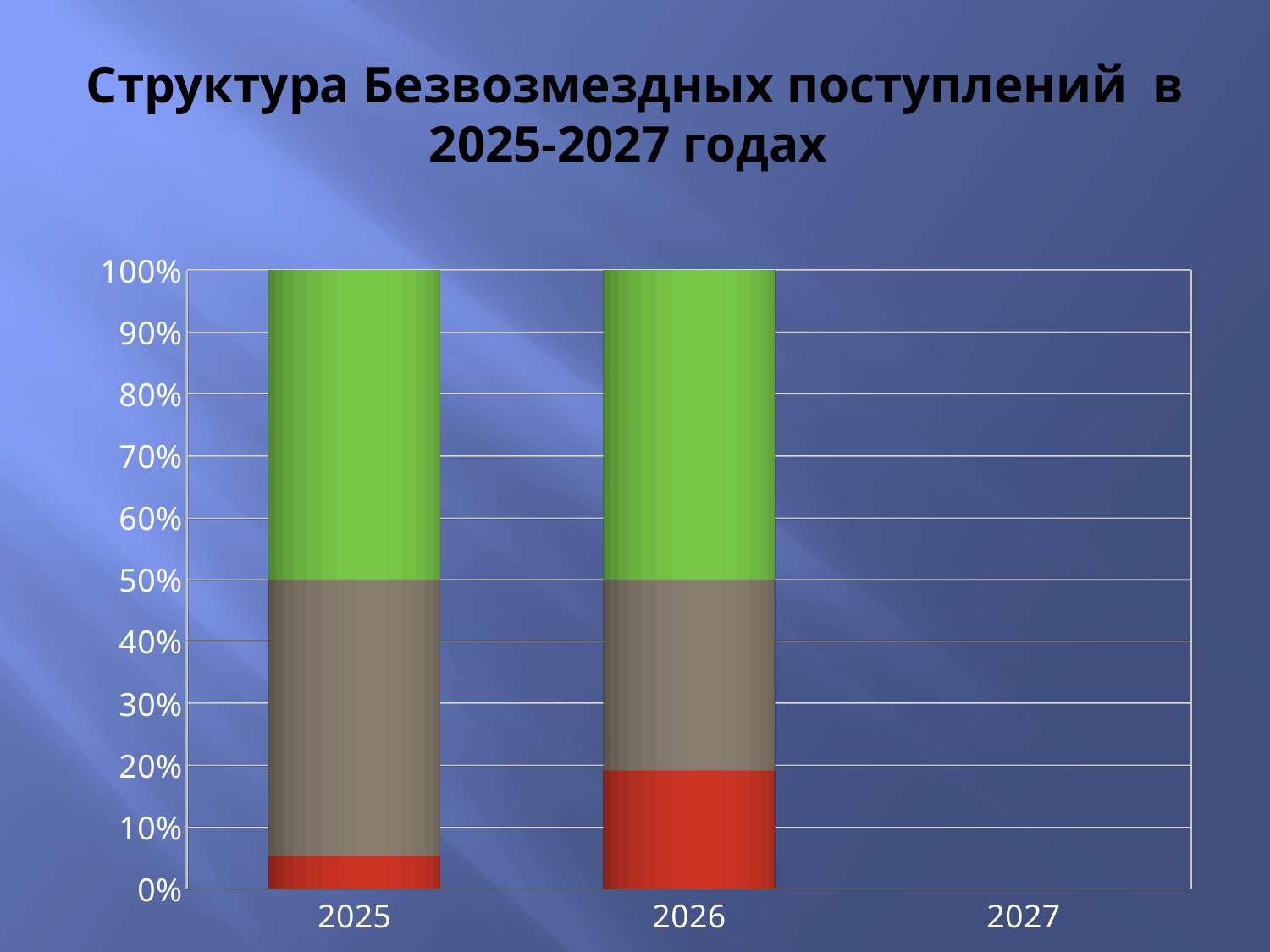
Is the red segment of the 2026 bar greater or less than 10%? greater At what percentage does the green segment of the 2025 bar begin? 50% Which year has the larger red segment, 2025 or 2026? 2026 What is the total height of the 2025 stacked bar? 100% How many year categories are shown on the x axis? 3 Which year category has no bar plotted? 2027 What kind of chart is shown on the slide? Stacked bar chart Is the grey segment of the 2026 bar greater or less than 20% of the total? greater Is the red segment of the 2025 bar greater or less than 10%? less At what percentage does the green segment of the 2026 bar begin? 50% What is the title of the chart on the slide? Структура Безвозмездных поступлений в 2025-2027 годах Does the red segment rise or fall from 2025 to 2026? rise